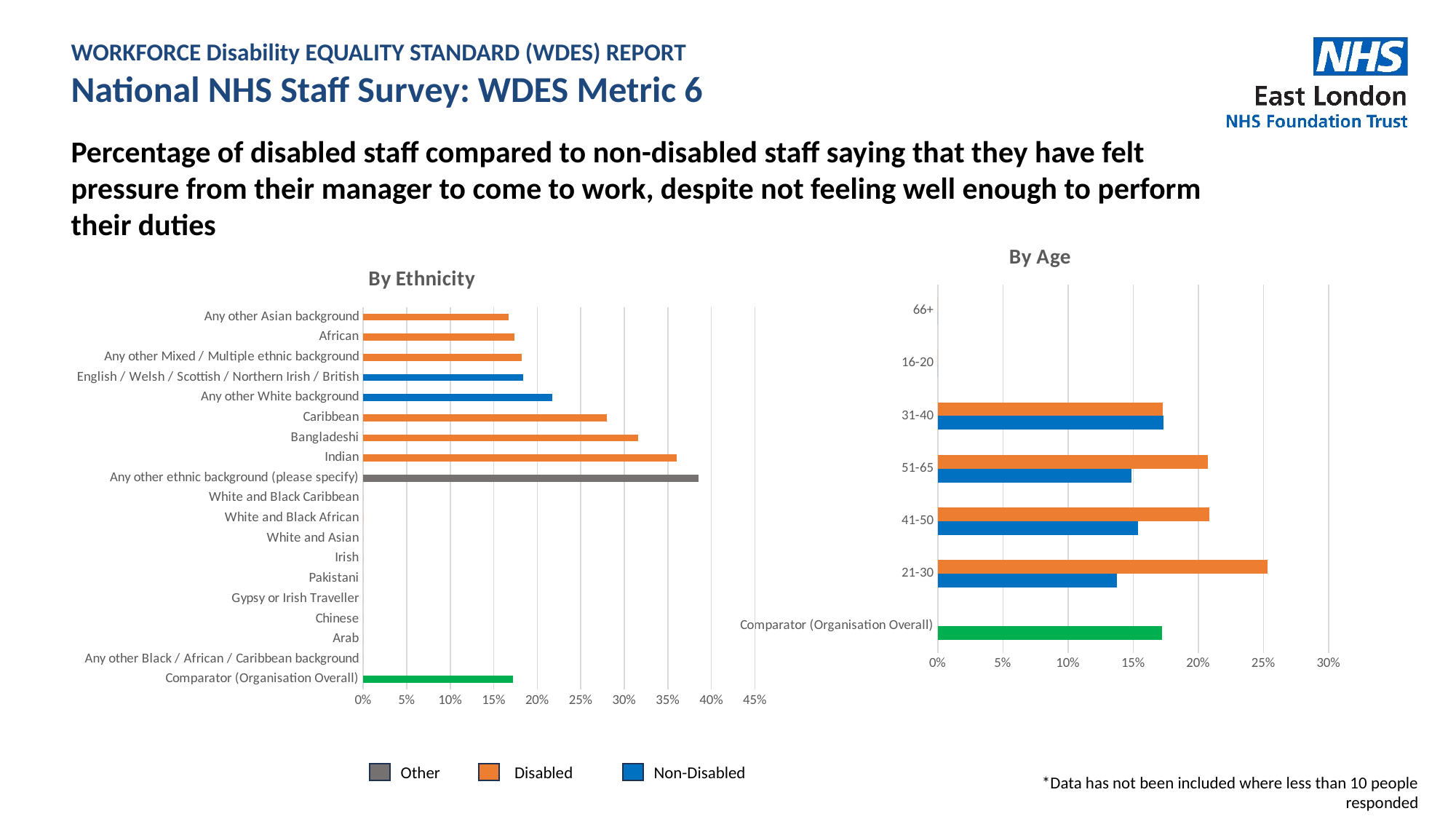
In the "By Ethnicity" chart, is the value for Indian greater or less than 30%? greater In the "By Age" chart, is the Non-Disabled value for 21-30 greater or less than 15%? less How many series does the legend below the "By Ethnicity" chart list? 3 In the "By Age" chart, which colour represents the Disabled series? orange In the "By Ethnicity" chart, is the value for Any other ethnic background (please specify) greater or less than 35%? greater In the "By Ethnicity" chart, which category has the highest value? Any other ethnic background (please specify) In the "By Age" chart, which is larger for the 51-65 group: the Disabled value or the Non-Disabled value? Disabled What type of chart is the "By Ethnicity" chart? bar chart In the "By Age" chart, which age group has the highest Disabled value? 21-30 In the "By Ethnicity" chart, which is larger: the value for Bangladeshi or the value for Caribbean? Bangladeshi How many categories are listed on the vertical axis of the "By Ethnicity" chart? 19